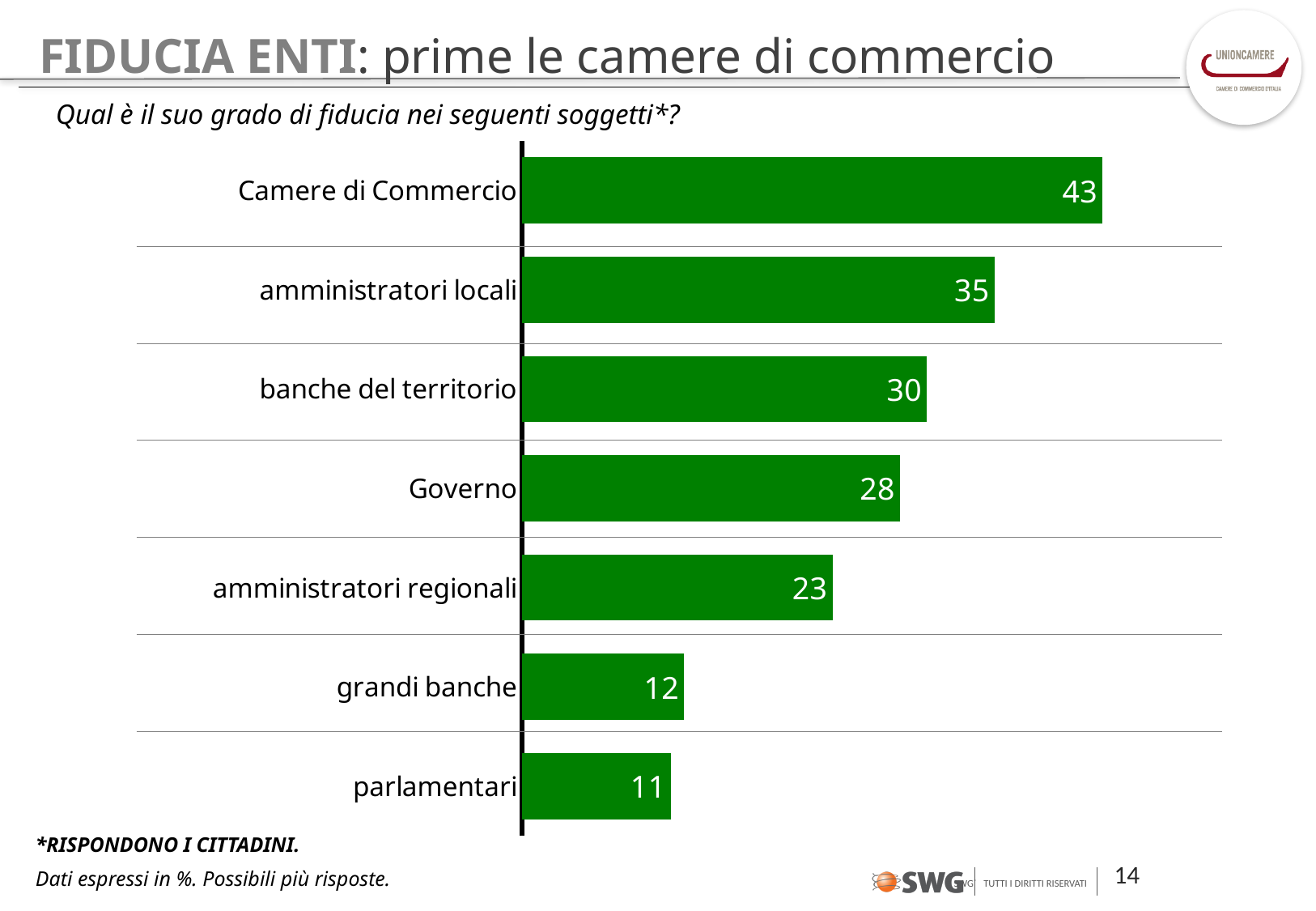
Which category has the lowest value? parlamentari What is the value for Camere di Commercio? 43 What is the difference between the values for Camere di Commercio and amministratori locali? 8 What is the value for grandi banche? 12 Which is larger, the value for Governo or the value for amministratori regionali? Governo Which category has the highest value? Camere di Commercio How many categories are shown in the chart? 7 What colour are the bars in the chart? green What kind of chart is shown on the slide? bar chart What is the value for Governo? 28 What is the value for amministratori regionali? 23 What is the difference between the values for banche del territorio and grandi banche? 18